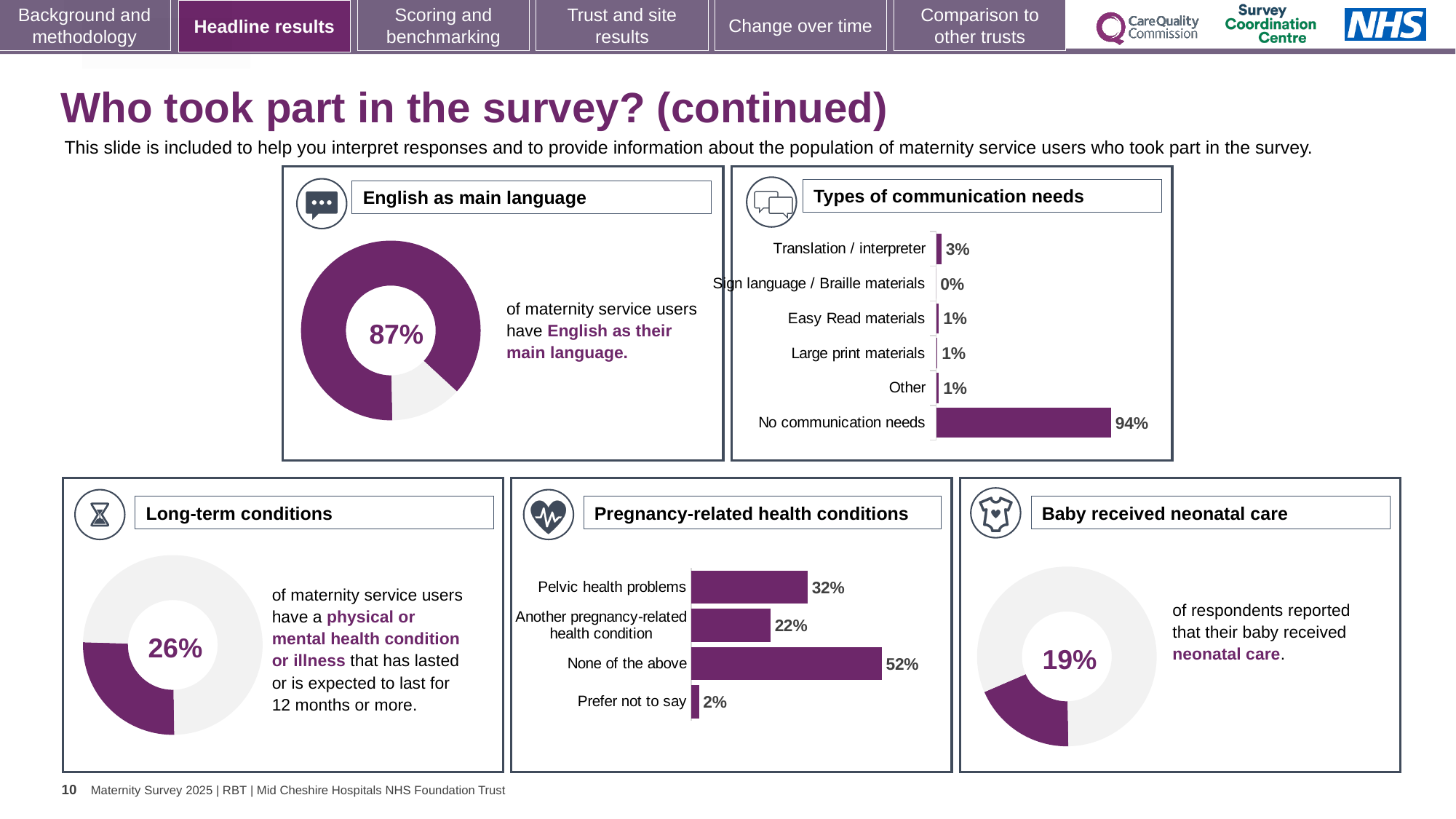
In the 'Baby received neonatal care' chart, what percentage of respondents reported that their baby received neonatal care? 19% In the 'English as main language' chart, what percentage of maternity service users have English as their main language? 87% In the 'Pregnancy-related health conditions' chart, which category has the highest value? None of the above In the 'Pregnancy-related health conditions' chart, which is larger: 'Pelvic health problems' or 'Prefer not to say'? Pelvic health problems In the 'Pregnancy-related health conditions' chart, what percentage is shown for 'Pelvic health problems'? 32% What kind of chart is used in the 'Pregnancy-related health conditions' panel? Bar chart In the 'Pregnancy-related health conditions' chart, what is the difference between 'None of the above' and 'Another pregnancy-related health condition'? 30% In the 'Long-term conditions' chart, what percentage of maternity service users have a physical or mental health condition or illness? 26% In the 'Types of communication needs' chart, what percentage is shown for 'Translation / interpreter'? 3% In the 'Types of communication needs' chart, which category has the lowest value? Sign language / Braille materials How many categories are shown in the 'Types of communication needs' chart? 6 In the 'Types of communication needs' chart, what percentage is shown for 'No communication needs'? 94%